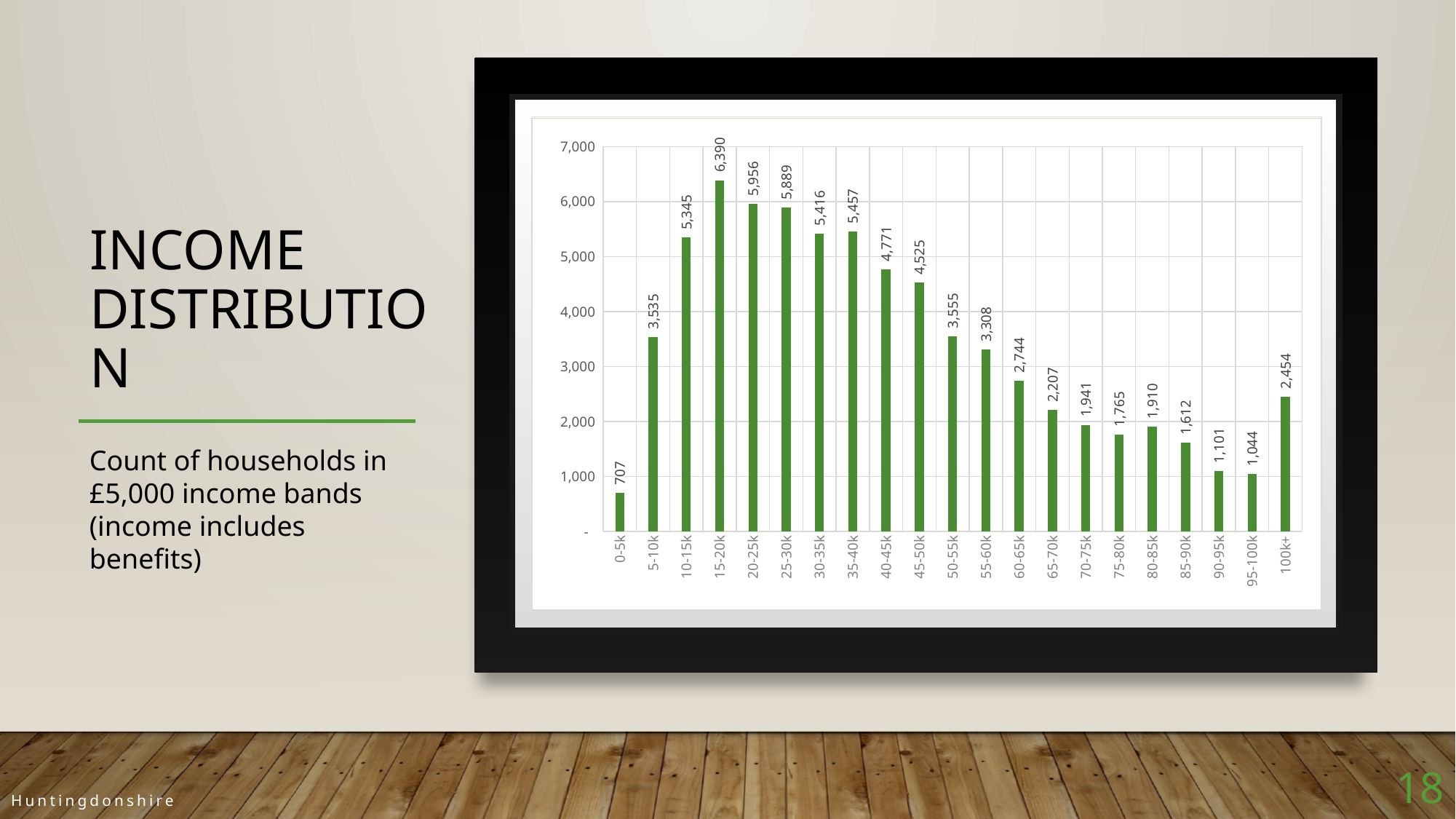
Which income band has the lowest count of households? 0-5k Which band has more households, 80-85k or 75-80k? 80-85k Which income band has the highest count of households? 15-20k What kind of chart is shown on the slide? bar chart Do the values generally rise or fall from the 15-20k band to the 95-100k band? fall What is the difference between the 100k+ band and the 95-100k band? 1,410 Is the value for the 40-45k band greater or less than 4,000? greater What is the difference between the 15-20k band and the 0-5k band? 5,683 How many households are in the 15-20k income band? 6,390 How many income bands are shown on the x axis? 21 What is the value shown for the 0-5k band? 707 What is the value shown for the 100k+ band? 2,454